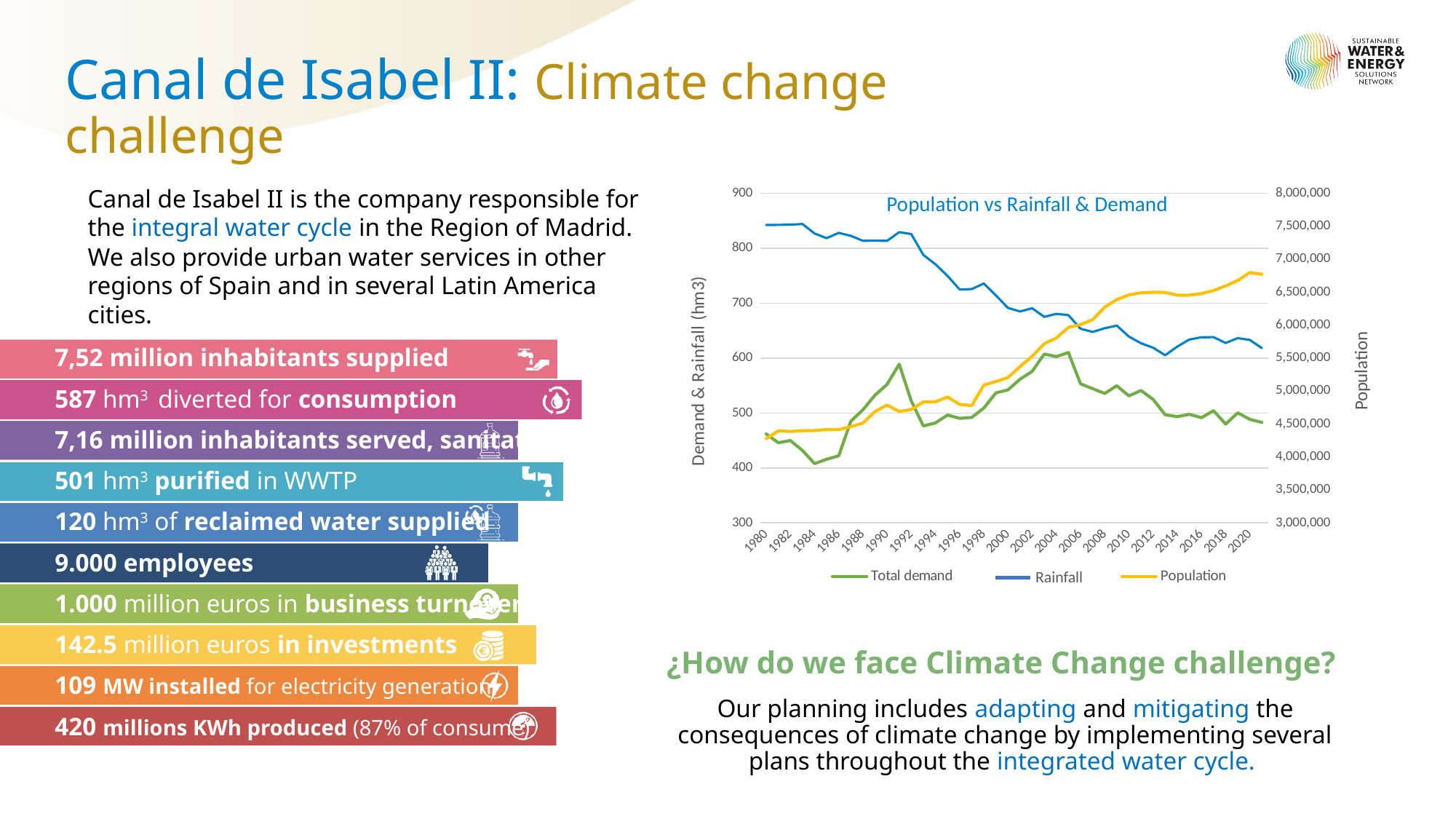
What is the title of the chart? Population vs Rainfall & Demand Is the Total demand value for 1991 greater or less than 500? greater Is the Rainfall value for 1980 greater or less than 800? greater Is the Rainfall value for 2020 greater or less than 700? less How many series does the legend of the chart list? 3 What kind of chart is shown on the slide? Line chart Does the Rainfall series rise or fall overall from 1980 to 2020? Falls Does the Population series rise or fall from 1980 to 2020? Rises Which colour is used for the Population series in the chart? Yellow